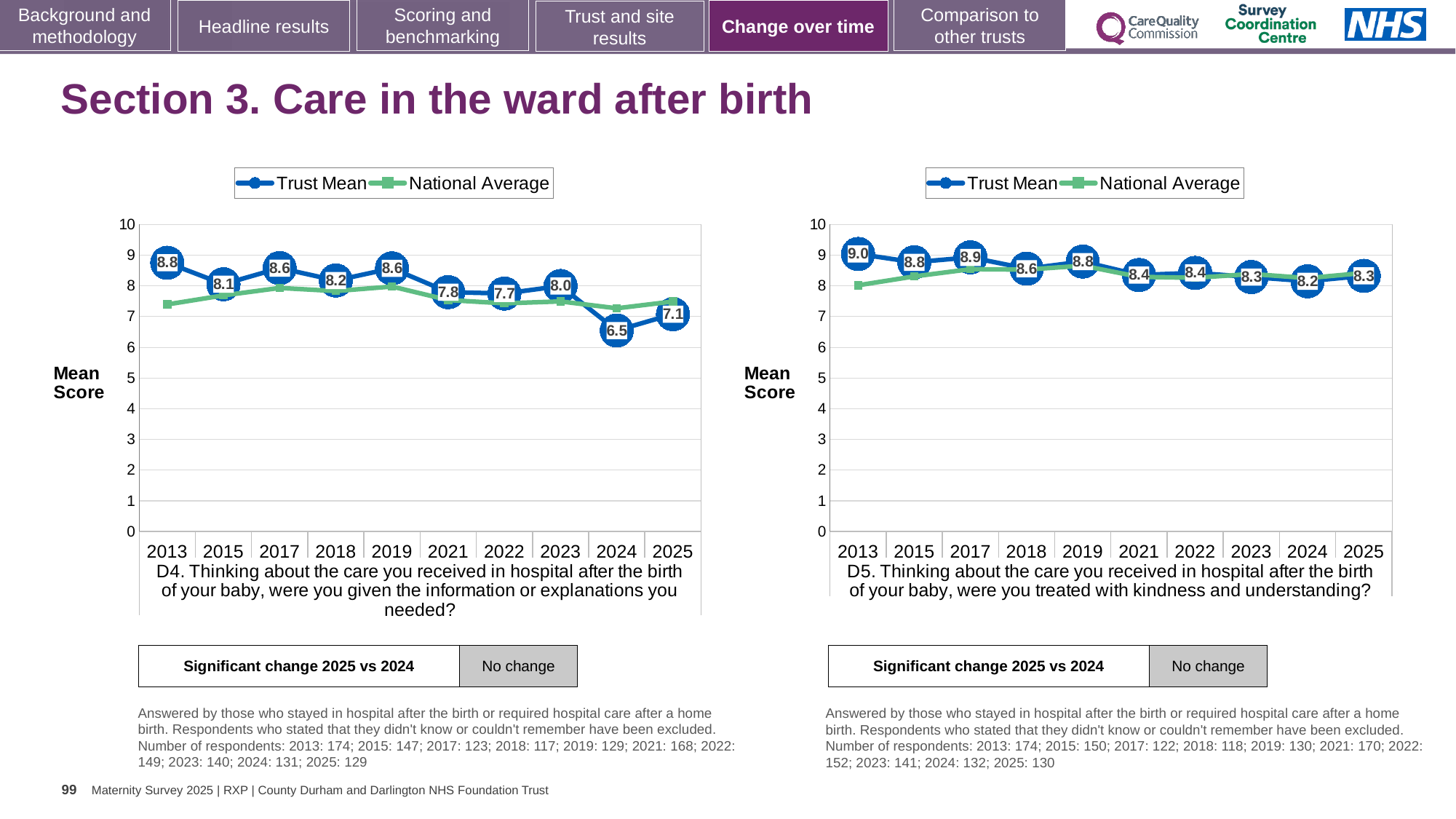
In the left chart (D4), what is the Trust Mean for 2024? 6.5 In the left chart (D4), what is the difference between the Trust Mean in 2013 and in 2024? 2.3 In the right chart (D5), which year has the highest Trust Mean? 2013 In the left chart (D4), which year has the lowest Trust Mean? 2024 How many years are plotted on the x axis of the right chart (D5)? 10 In the left chart (D4), what is the Trust Mean for 2013? 8.8 In the left chart (D4), is the National Average for 2013 greater or less than 8? less How many series does the legend of the left chart (D4) list? 2 In the right chart (D5), what is the difference between the Trust Mean in 2013 and in 2024? 0.8 In the left chart (D4), is the Trust Mean higher in 2025 or in 2024? 2025 What kind of chart is the right chart (D5)? Line chart In the right chart (D5), what is the Trust Mean for 2025? 8.3